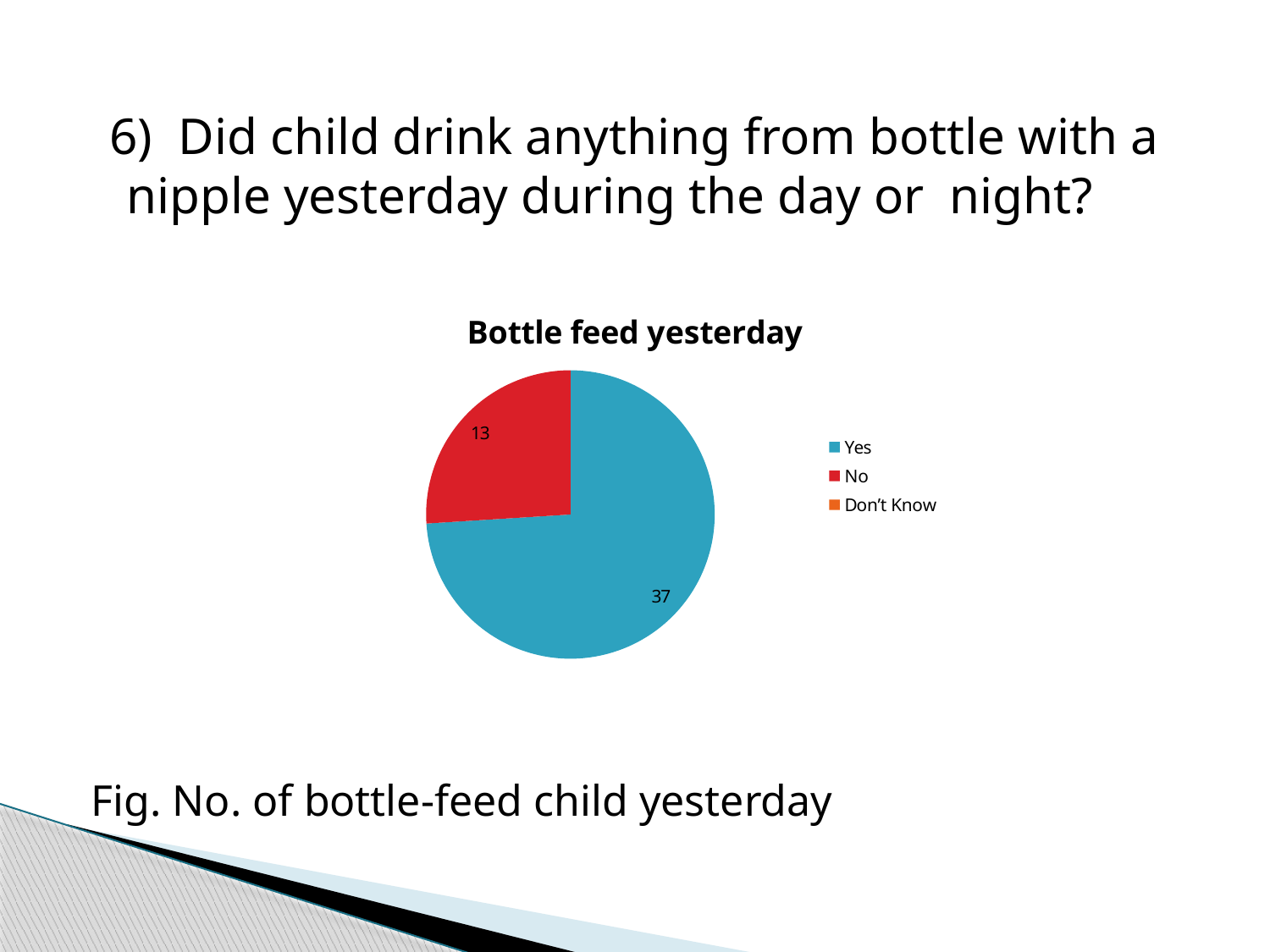
What is the value for the Yes slice? 37 What is the title of the chart? Bottle feed yesterday Which category has the largest slice of the pie? Yes How many entries does the legend list? 3 What is the value for the No slice? 13 Which of the two visible slices, Yes or No, is smaller? No How many slices are visible in the pie? 2 What colour is the Yes slice? blue Which is larger, the value for Yes or the value for No? Yes What is the difference between the Yes value and the No value? 24 What type of chart is shown on the slide? pie chart